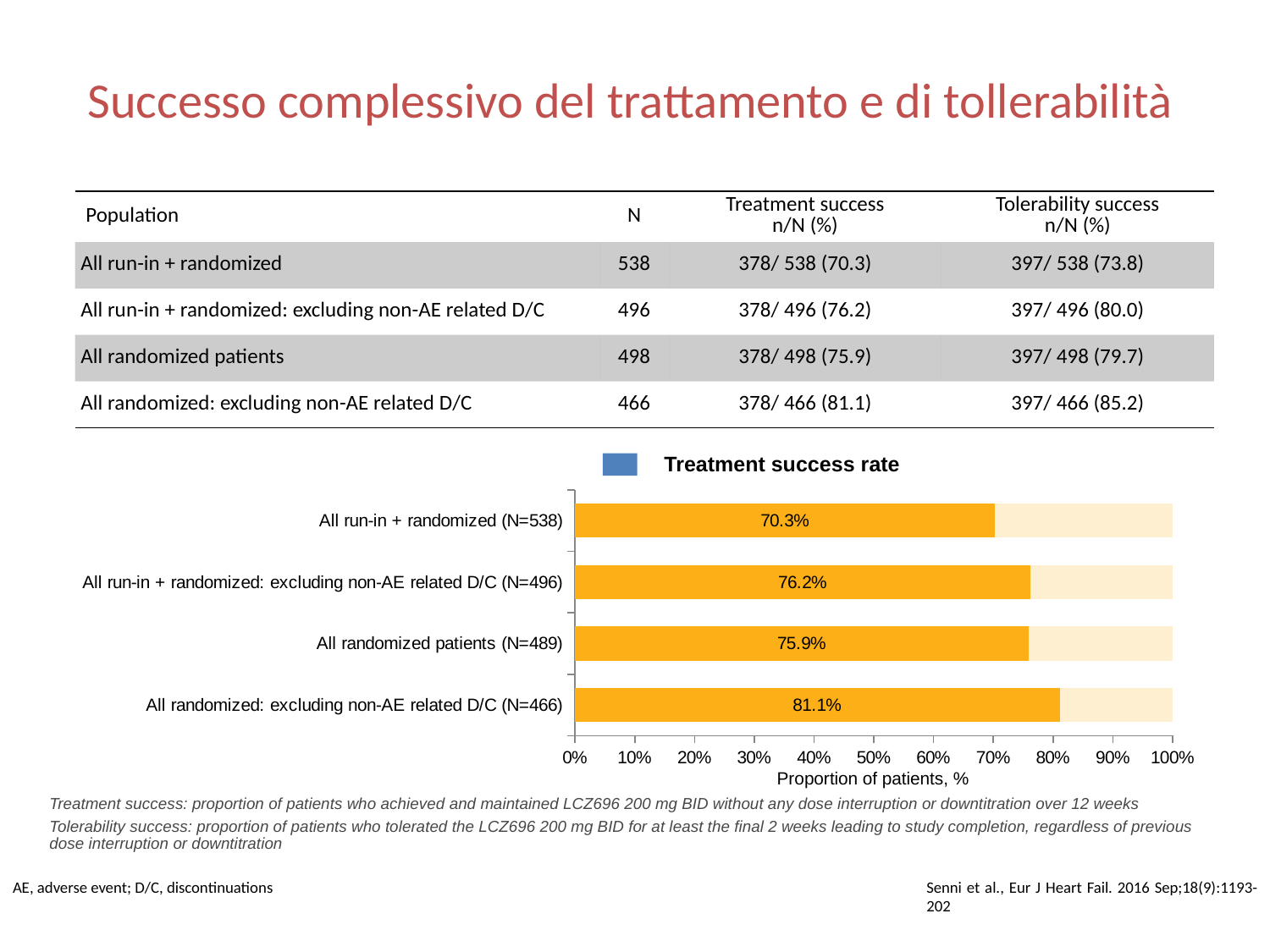
What is the treatment success rate for All run-in + randomized: excluding non-AE related D/C (N=496)? 76.2% What is the treatment success rate for All randomized: excluding non-AE related D/C (N=466)? 81.1% Which has a higher treatment success rate: All run-in + randomized (N=538) or All randomized patients (N=489)? All randomized patients (N=489) Which population has the highest treatment success rate? All randomized: excluding non-AE related D/C (N=466) What is the treatment success rate for All run-in + randomized (N=538)? 70.3% How many populations are shown in the bar chart? 4 Which population has the lowest treatment success rate? All run-in + randomized (N=538) What is the difference in treatment success rate between All randomized: excluding non-AE related D/C (N=466) and All run-in + randomized (N=538)? 10.8% What type of chart is shown on the slide? bar chart What is the treatment success rate for All randomized patients (N=489)? 75.9% Is the treatment success rate for All run-in + randomized (N=538) greater or less than 80%? less What is the label of the x axis of the chart? Proportion of patients, %